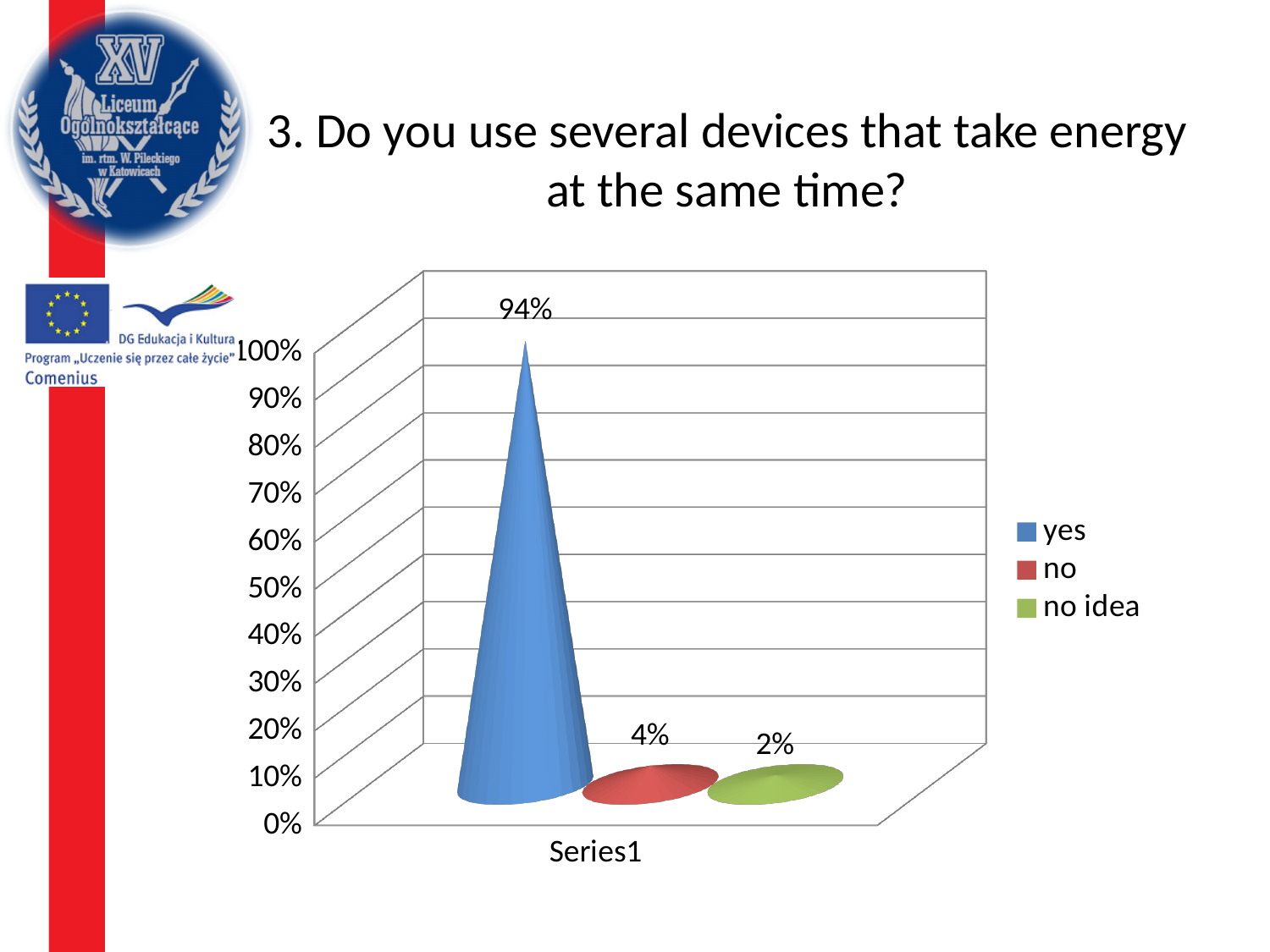
What is the difference between the "no" and "no idea" values? 2% What colour represents the "no idea" answer in the legend? green What percentage of respondents answered "no idea"? 2% Which answer has the highest value? yes Is the value for "yes" greater or less than 90%? greater Which answer has the lowest value? no idea What is the difference between the "yes" and "no" values? 90% Which is larger, the value for "no" or the value for "no idea"? no What percentage of respondents answered "yes"? 94% What percentage of respondents answered "no"? 4% How many series does the legend list? 3 What kind of chart is shown on the slide? bar chart